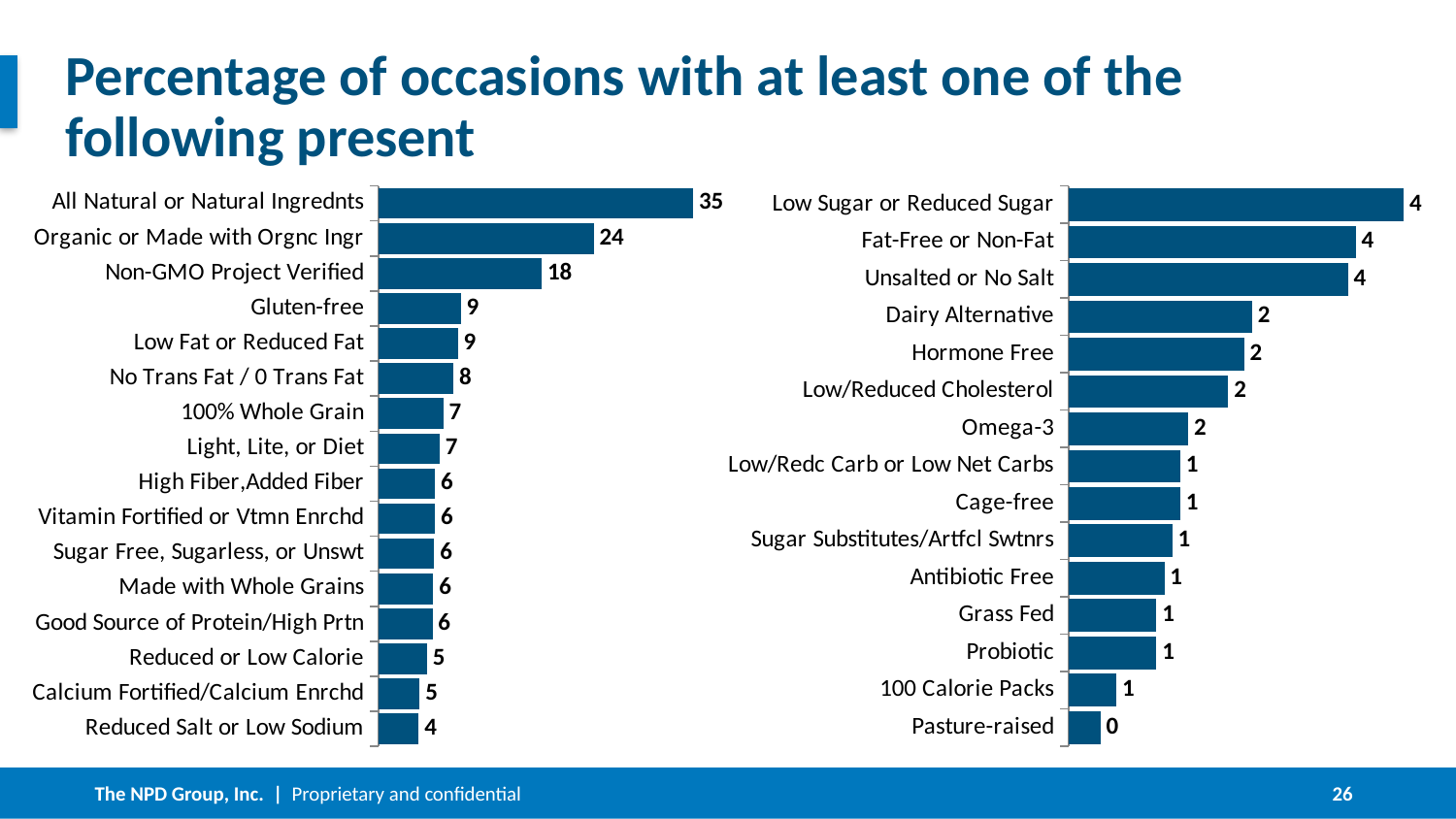
On the right chart, what is the value for Dairy Alternative? 2 On the left chart, which category has the highest value? All Natural or Natural Ingrednts On the left chart, what is the value for All Natural or Natural Ingredients? 35 On the left chart, which is larger: the value for Gluten-free or the value for Reduced or Low Calorie? Gluten-free On the left chart, which category has the lowest value? Reduced Salt or Low Sodium On the right chart, what is the value for Pasture-raised? 0 On the right chart, which category has the lowest value? Pasture-raised On the left chart, what is the difference between the values for All Natural or Natural Ingredients and Organic or Made with Organic Ingredients? 11 How many categories are shown on the left chart? 16 On the left chart, what is the value for Non-GMO Project Verified? 18 What type of chart is the left chart? Bar chart How many categories are shown on the right chart? 15